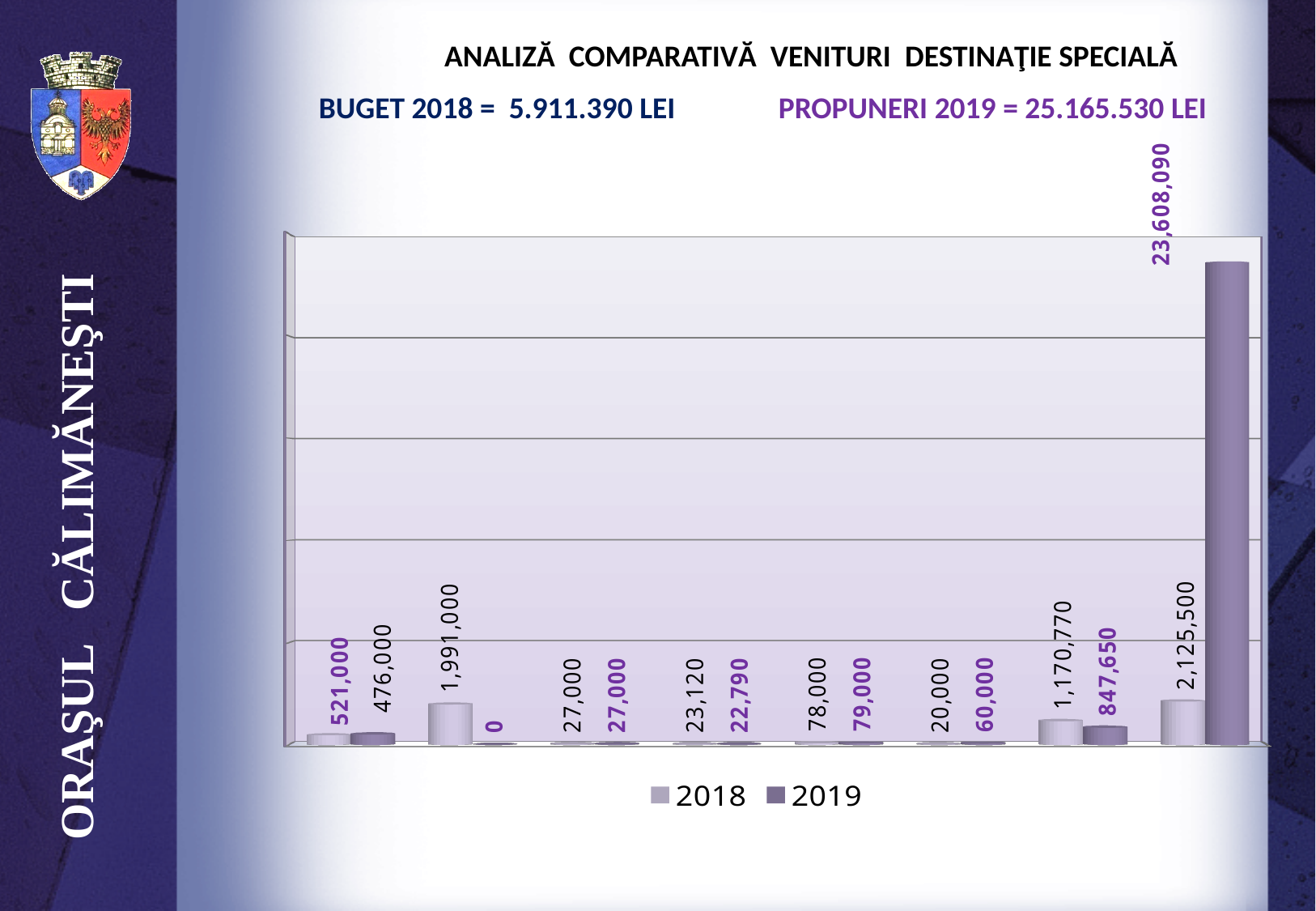
What kind of chart is shown on the slide? bar chart What is the 2019 value for the rightmost (eighth) category group? 23,608,090 How many series does the chart legend list? 2 What are the two entries in the chart legend? 2018 and 2019 What is the difference between the 2018 and 2019 values in the seventh category group? 323,120 What is the difference between the 2019 and 2018 values in the rightmost category group? 21,482,590 Which category group has the lowest 2019 value? the second group (0) How many category groups of bars are plotted in the chart? 8 Which category group has the highest 2019 value? the eighth (rightmost) group In the second category group from the left, which is larger: the 2018 value or the 2019 value? 2018 What is the 2018 value for the second category group from the left? 1,991,000 What is the 2019 value for the seventh category group from the left? 847,650